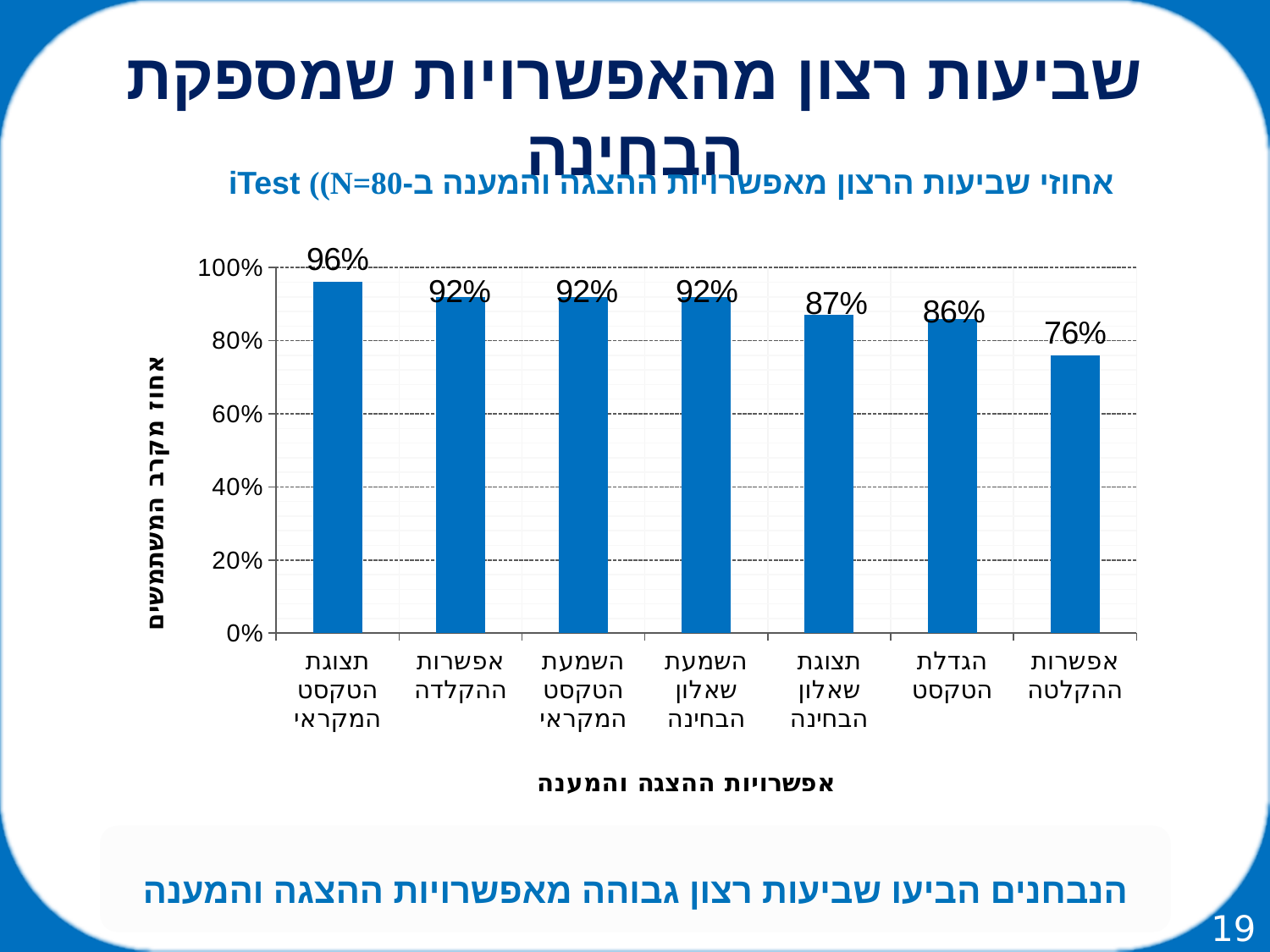
What is the difference between the values for תצוגת הטקסט המקראי and אפשרות ההקלטה? 20% How many categories are shown on the x axis? 7 What is the value for אפשרות ההקלטה? 76% What is the value for תצוגת הטקסט המקראי? 96% Which is larger, the value for אפשרות ההקלדה or the value for הגדלת הטקסט? אפשרות ההקלדה Is the value for אפשרות ההקלטה greater or less than 80%? less What is the label of the y axis? אחוז מקרב המשתמשים What kind of chart is shown on the slide? bar chart Which category has the lowest value? אפשרות ההקלטה What is the value for הגדלת הטקסט? 86% What is the value for תצוגת שאלון הבחינה? 87% Which category has the highest value? תצוגת הטקסט המקראי